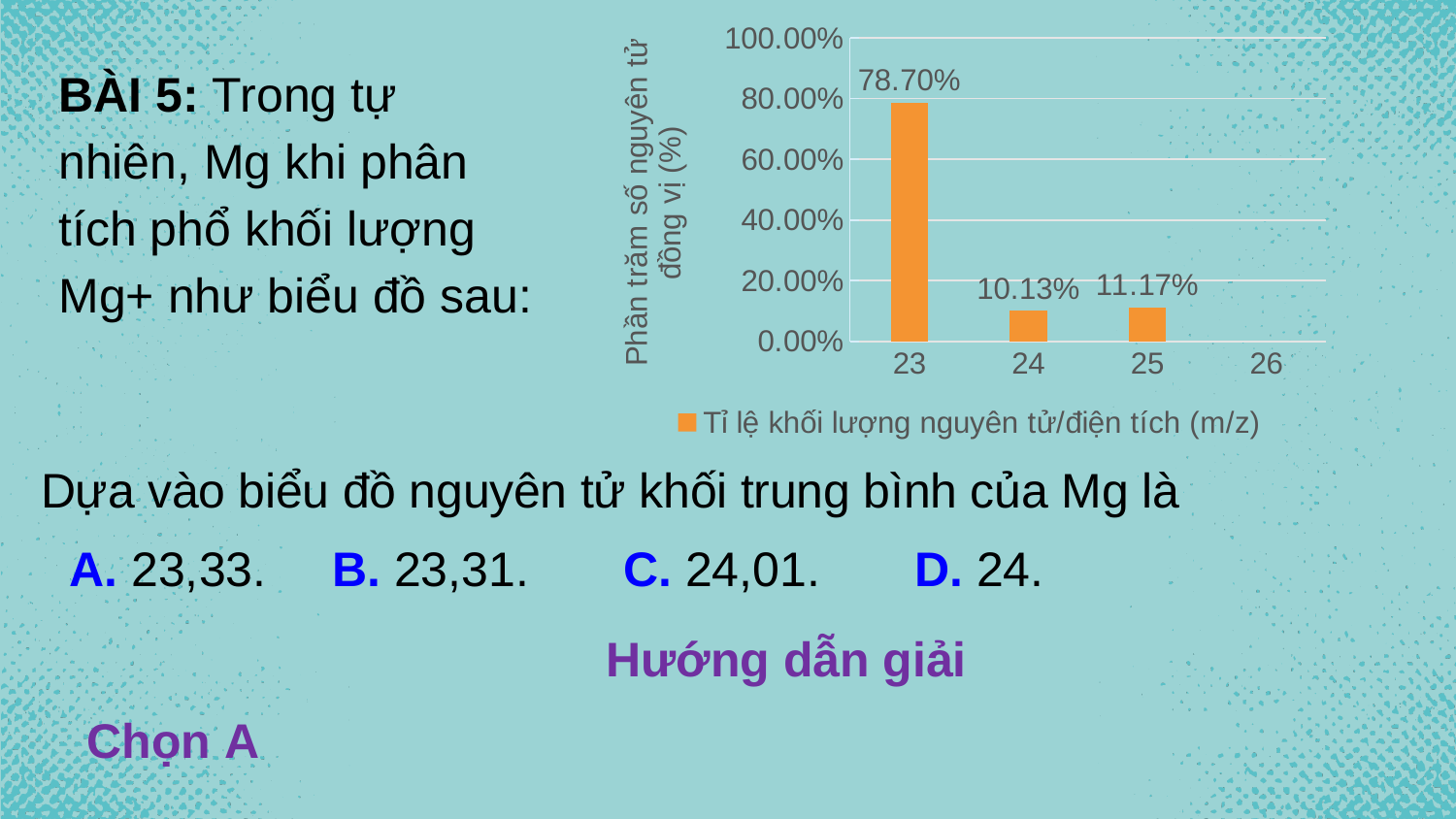
What is the value shown for category 23? 78.70% What is the difference between the values for 25 and 24? 1.04% What is the legend entry for the series? Tỉ lệ khối lượng nguyên tử/điện tích (m/z) Is the value for 23 greater or less than 60.00%? greater What is the difference between the values for 23 and 24? 68.57% Which is larger, the value for 24 or the value for 25? 25 What is the value shown for category 25? 11.17% How many series does the legend list? 1 What is the value shown for category 24? 10.13% Which category has the highest value? 23 What type of chart is shown on the slide? Bar chart Which of the labelled bars has the lowest value? 24